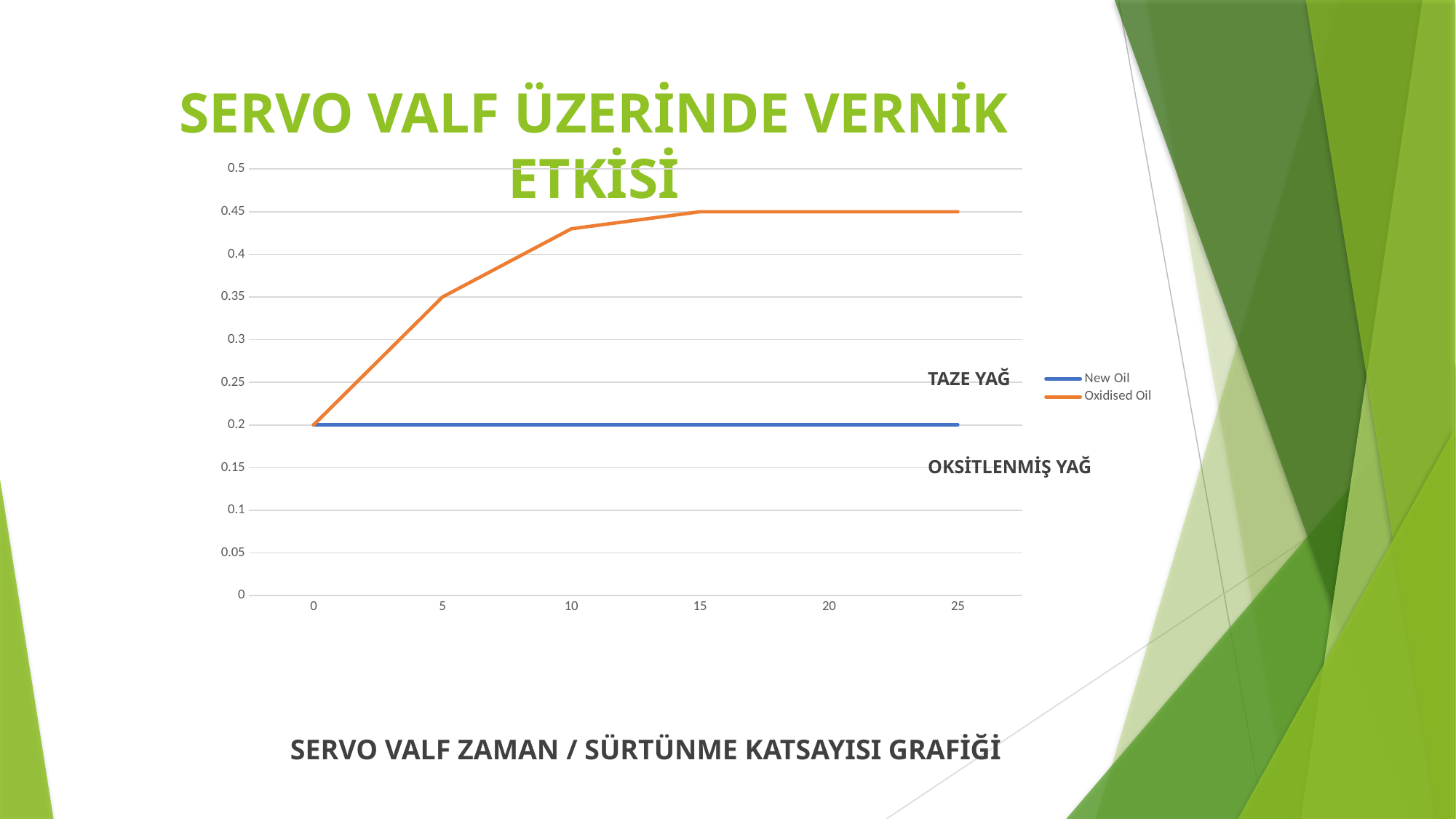
What is the difference between the Oxidised Oil value and the New Oil value at x = 25? 0.25 Which series has the higher value at x = 20, New Oil or Oxidised Oil? Oxidised Oil What is the value of the New Oil series at x = 25? 0.2 What is the value of the Oxidised Oil series at x = 15? 0.45 Does the Oxidised Oil series rise or fall between x = 0 and x = 15? rise What kind of chart is shown on the slide? line chart Which colour is the Oxidised Oil line? orange What is the value of the Oxidised Oil series at x = 0? 0.2 How many series does the legend list? 2 Is the value of the Oxidised Oil series at x = 10 greater or less than 0.4? greater What is the value of the Oxidised Oil series at x = 5? 0.35 What are the two series named in the legend? New Oil and Oxidised Oil